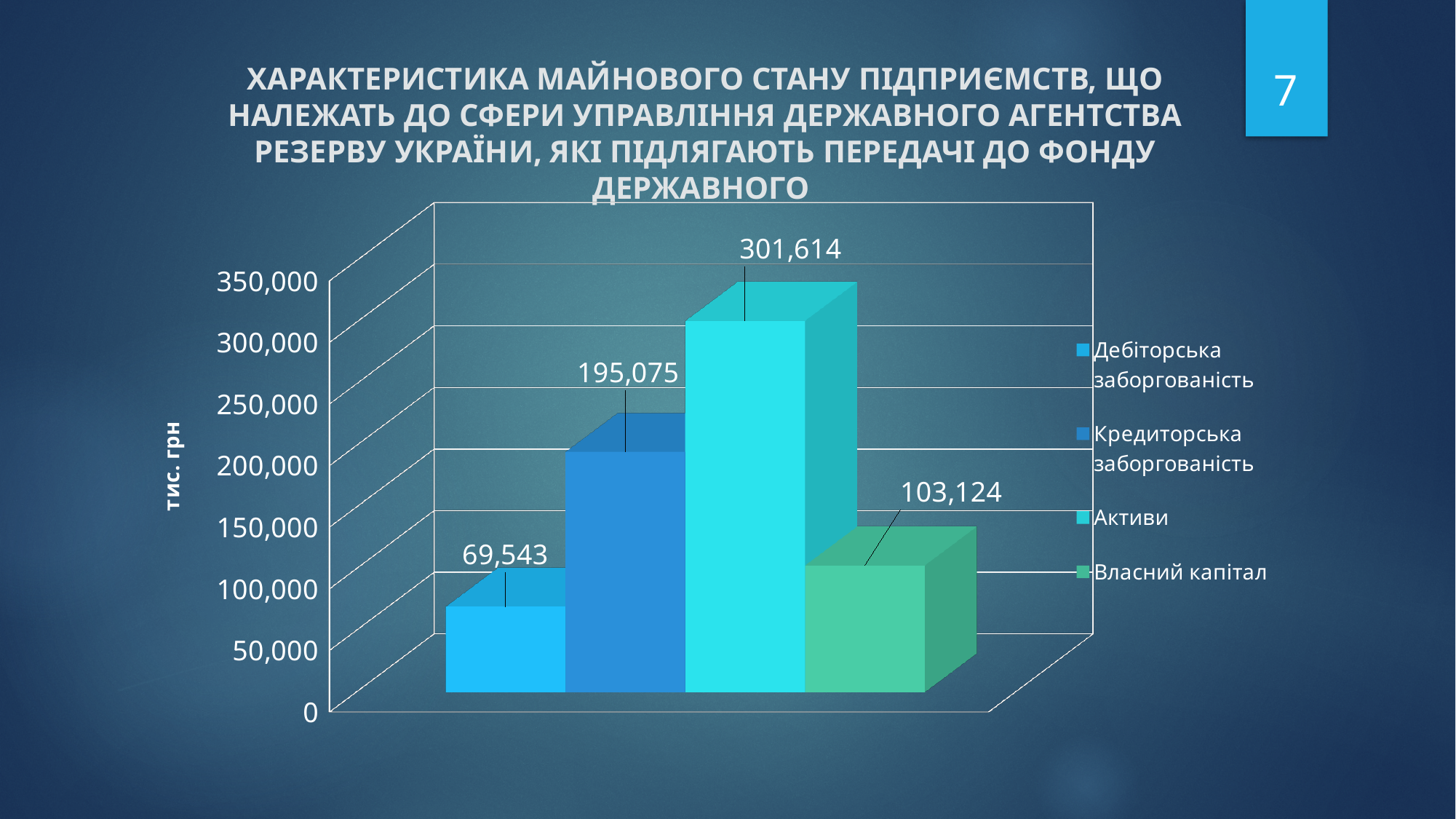
What is the value for Кредиторська заборгованість? 195,075 Which is larger, Власний капітал or Дебіторська заборгованість? Власний капітал What is the value for Дебіторська заборгованість? 69,543 Is the value for Кредиторська заборгованість greater or less than 150,000? greater Which series has the highest value? Активи What is the value for Власний капітал? 103,124 What is the difference between Активи and Кредиторська заборгованість? 106,539 What is the value for Активи? 301,614 What kind of chart is shown on the slide? bar chart Which series has the lowest value? Дебіторська заборгованість How many series does the legend list? 4 What is the label on the vertical axis of the chart? тис. грн